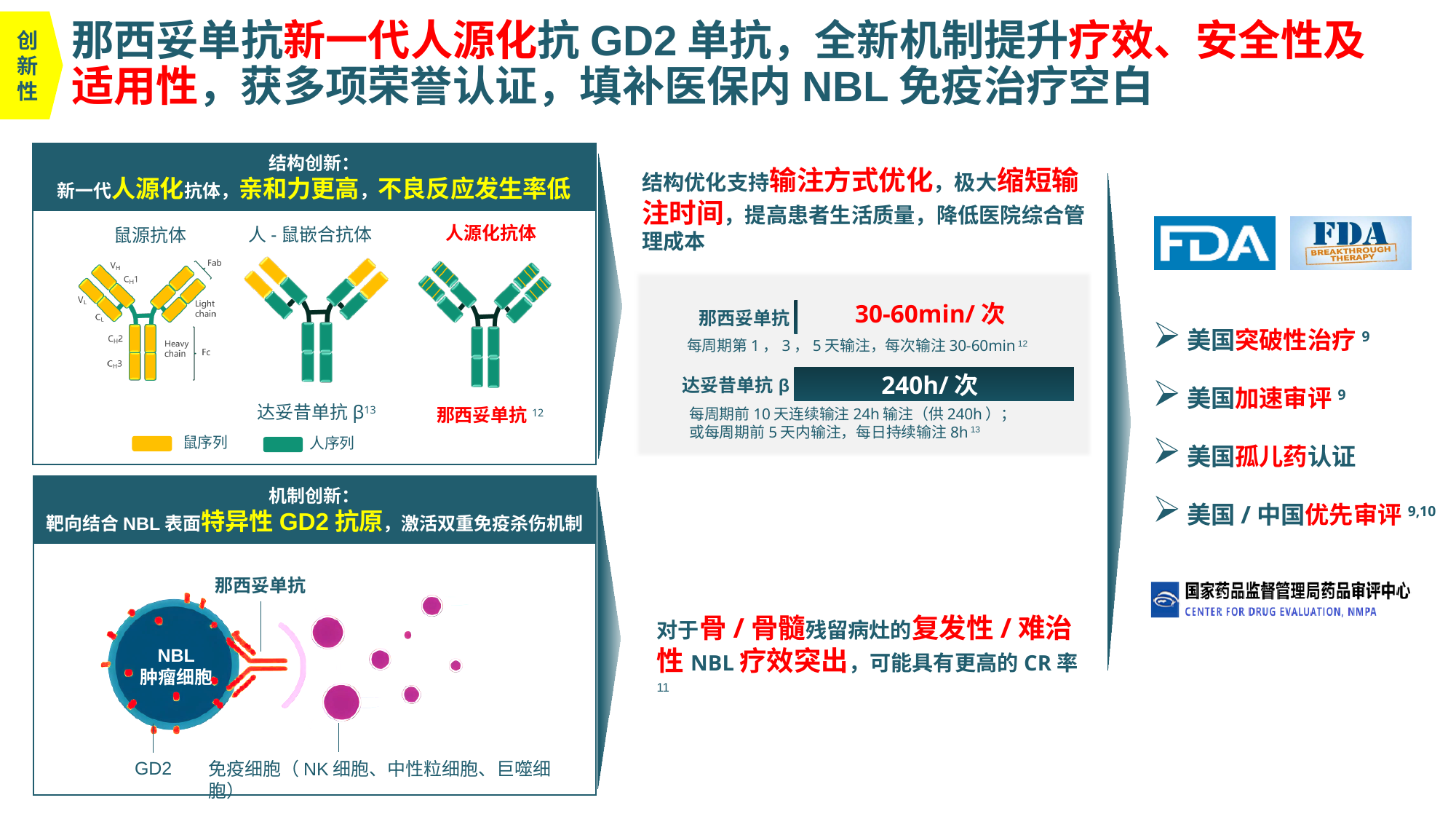
How many drugs are compared in the infusion-time chart? 2 What kind of chart is used to compare the infusion times of 那西妥单抗 and 达妥昔单抗β? bar chart In the infusion-time chart, which drug has the longer infusion time per administration? 达妥昔单抗β In the infusion-time chart, is the bar for 达妥昔单抗β longer or shorter than the bar for 那西妥单抗? longer In the infusion-time chart, what colour is the bar for 达妥昔单抗β? dark teal In the infusion-time chart, what is the value shown for 达妥昔单抗β? 240h/次 In the infusion-time chart, which drug has the shorter infusion time per administration? 那西妥单抗 In the infusion-time chart, what is the value shown for 那西妥单抗? 30-60min/次